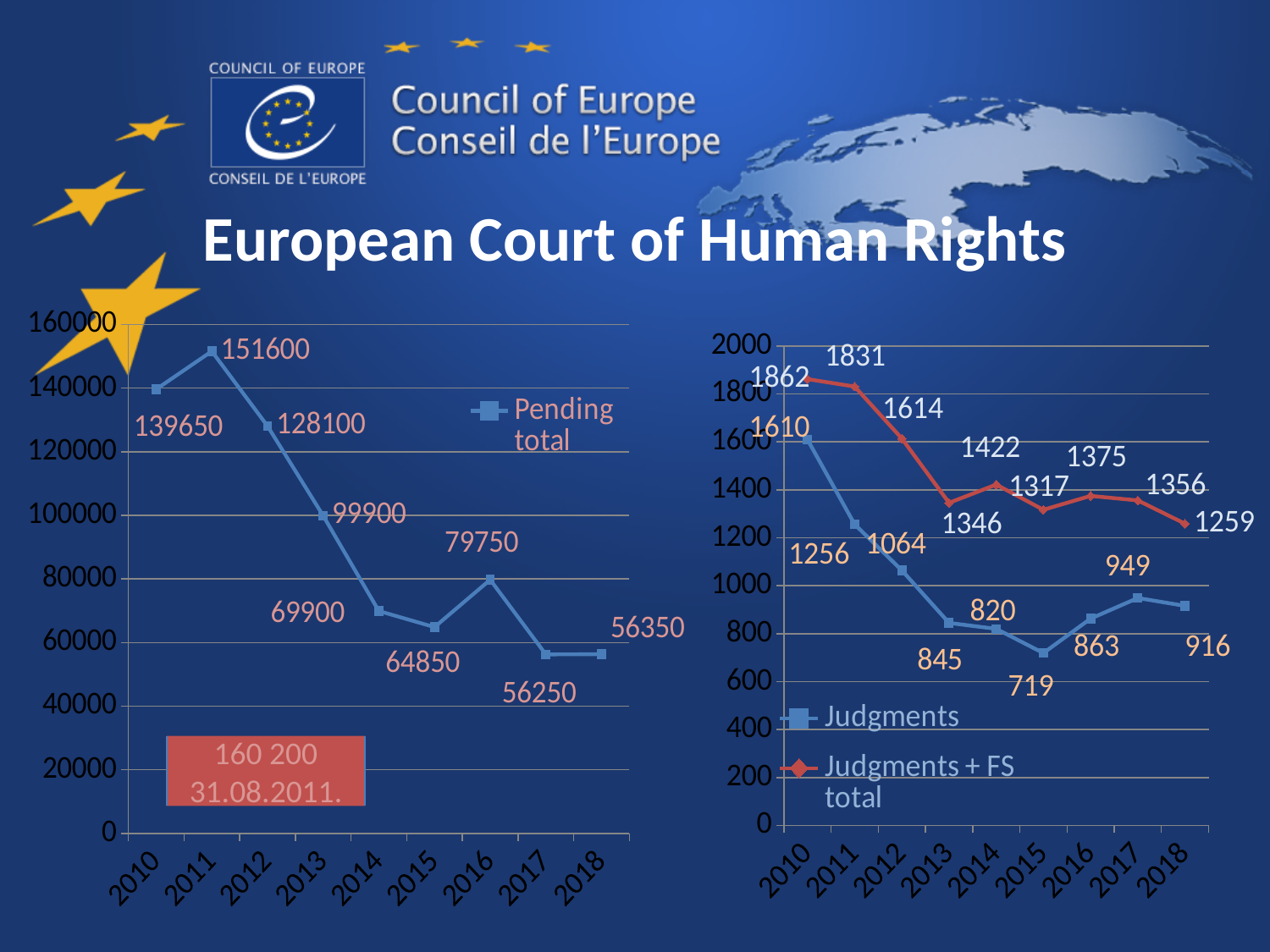
In the left chart (Pending total), how many years are plotted on the x axis? 9 In the right chart, how many series does the legend list? 2 In the right chart, is the Judgments value for 2010 greater or less than the Judgments value for 2017? greater In the left chart (Pending total), what is the value for 2016? 79750 In the left chart (Pending total), what is the value for 2011? 151600 In the right chart, what is the difference between Judgments + FS total and Judgments in 2018? 343 In the right chart, which year has the lowest Judgments value? 2015 In the left chart (Pending total), which year has the highest value? 2011 In the right chart, what is the Judgments value for 2015? 719 In the right chart, what is the Judgments + FS total value for 2010? 1862 In the left chart (Pending total), what is the difference between the 2010 value and the 2012 value? 11550 What kind of chart is the left chart (Pending total)? Line chart